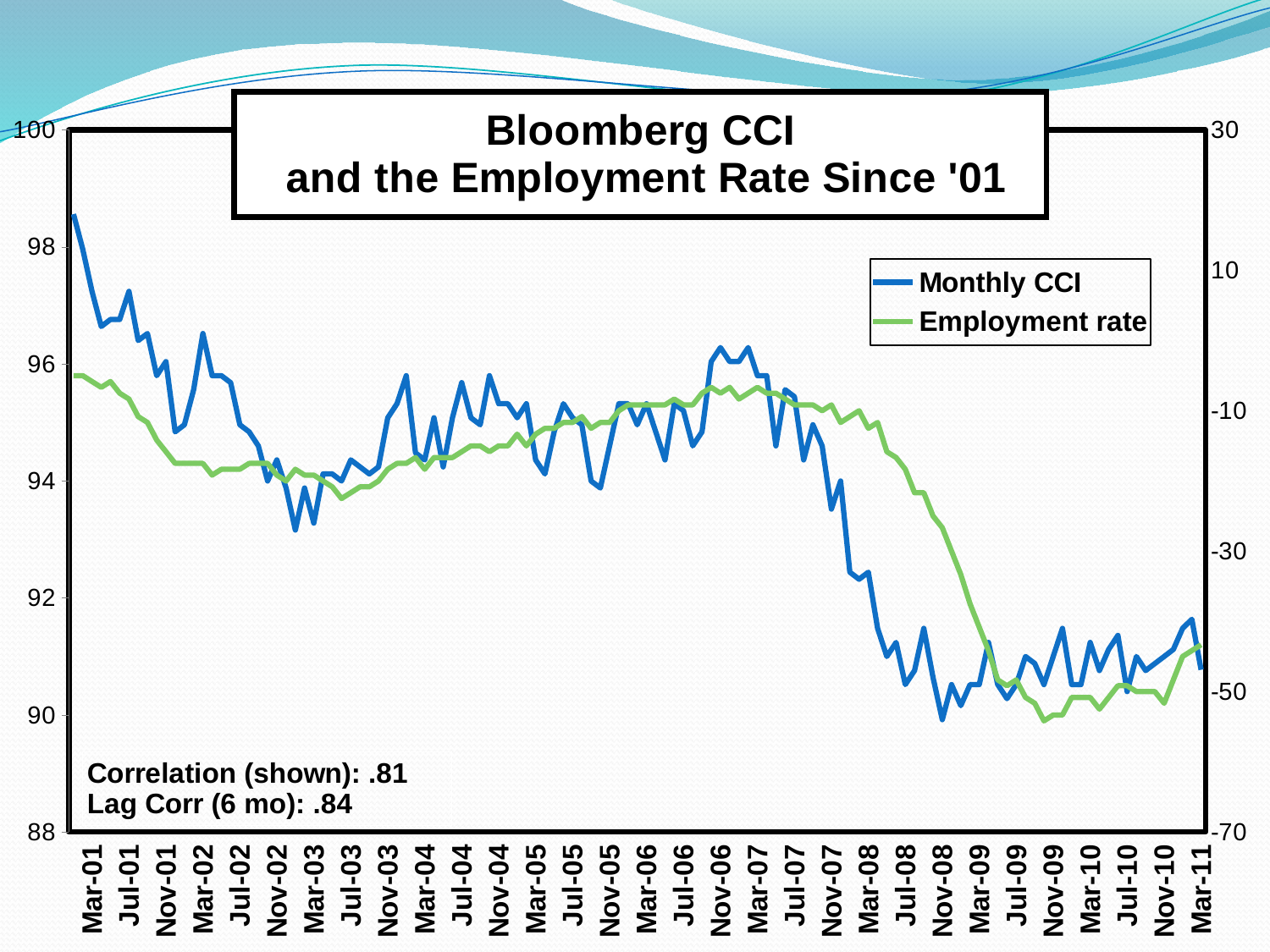
Does the Employment rate line rise or fall between Mar-08 and Mar-09? Fall Does the Monthly CCI line rise or fall between Mar-01 and Nov-02? Fall What is the title of the chart? Bloomberg CCI and the Employment Rate Since '01 Reading against the left axis, is the Employment rate at Nov-09 greater or less than 92? less What kind of chart is shown on the slide? Line chart What is the highest value shown on the right-hand axis? 30 What correlation value is shown on the chart for the two series? .81 Reading against the left axis, is the Employment rate at Mar-01 greater or less than 94? greater How many series does the legend list? 2